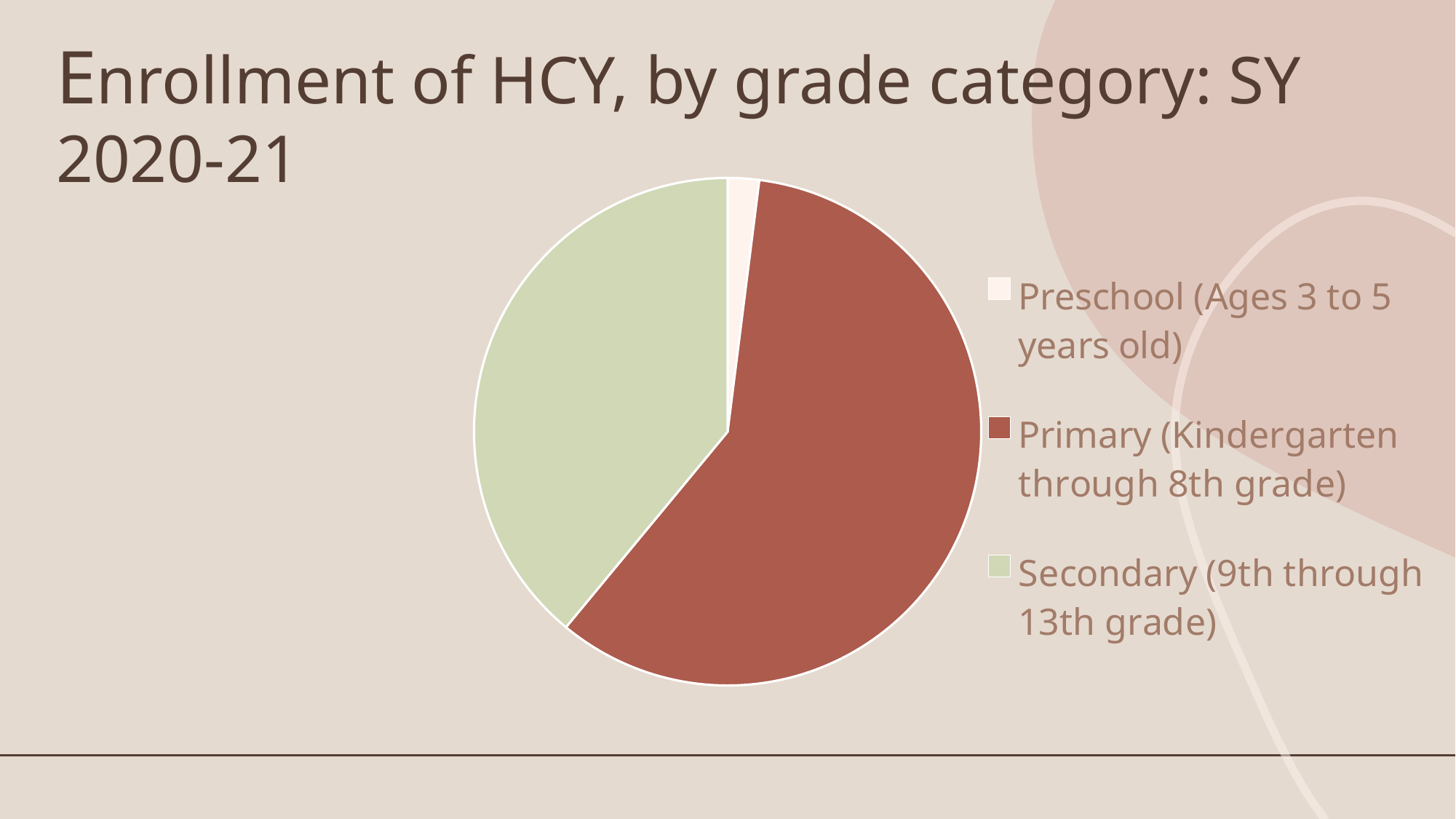
Does the Primary (Kindergarten through 8th grade) slice make up more or less than half of the pie? more Which has a larger share of enrollment, Primary (Kindergarten through 8th grade) or Secondary (9th through 13th grade)? Primary (Kindergarten through 8th grade) Which grade category has the largest share of HCY enrollment in SY 2020-21? Primary (Kindergarten through 8th grade) Which grade category has the smallest share of HCY enrollment in SY 2020-21? Preschool (Ages 3 to 5 years old) Which grade category is shown in green on the pie chart? Secondary (9th through 13th grade) Which has a larger share of enrollment, Secondary (9th through 13th grade) or Preschool (Ages 3 to 5 years old)? Secondary (9th through 13th grade) What kind of chart is shown on the slide? pie chart What is the title of the chart on the slide? Enrollment of HCY, by grade category: SY 2020-21 How many grade categories does the pie chart show? 3